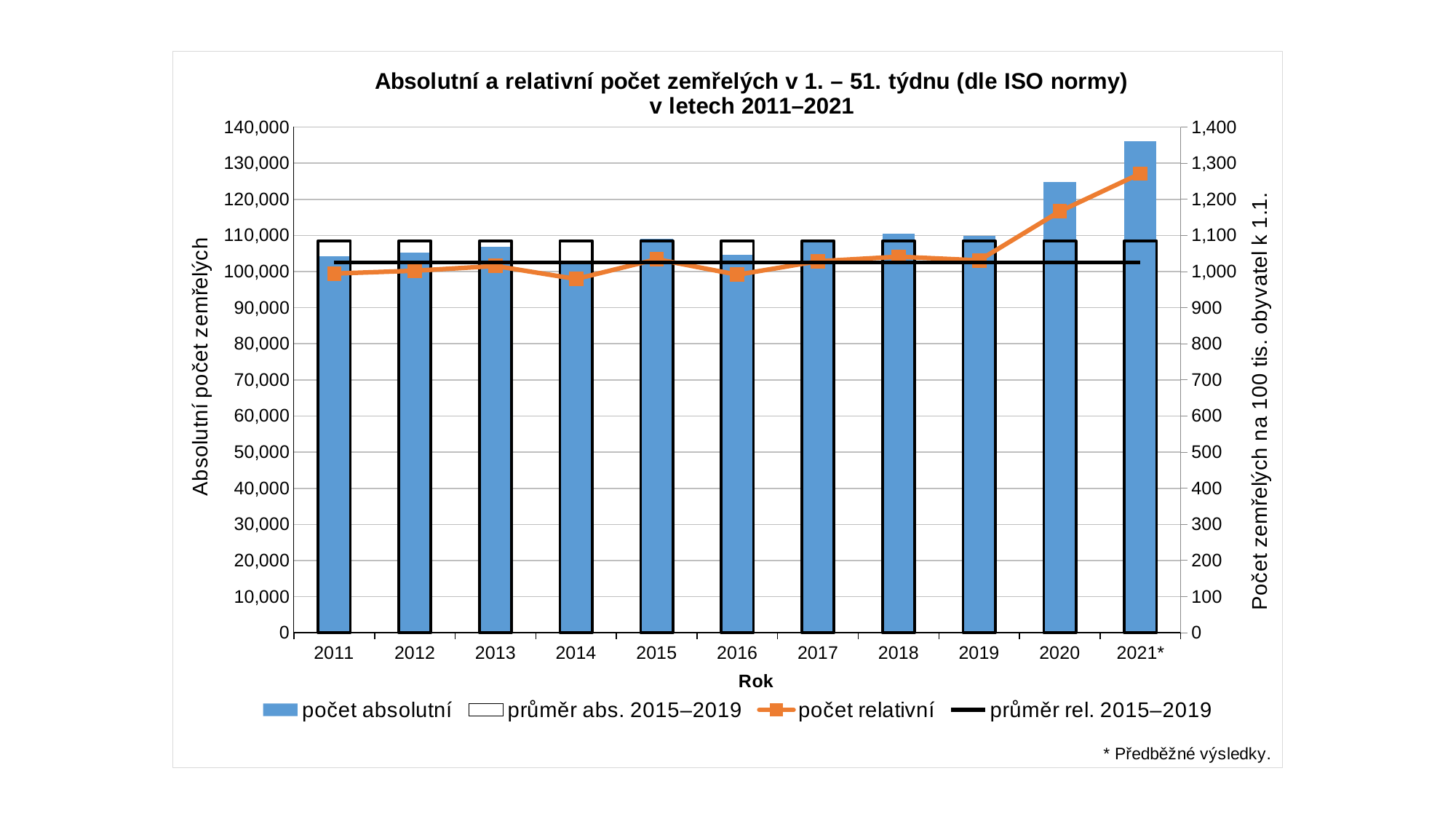
Does the počet relativní line rise or fall from 2019 to 2021*? rises Which year has the highest value for počet absolutní? 2021* What colour are the počet absolutní bars in the chart? Blue Is the počet relativní value for 2021* greater or less than 1,200? greater Which year has the larger počet absolutní value, 2019 or 2020? 2020 How many years are shown on the x axis of the chart? 11 What kind of chart is shown on the slide? A bar chart combined with a line chart Which year has the lowest value for počet absolutní? 2014 Is the počet absolutní value for 2020 greater or less than 120,000? greater What is the title of the x axis of the chart? Rok How many series does the chart legend list? 4 Is the počet absolutní value for 2014 greater or less than 100,000? greater